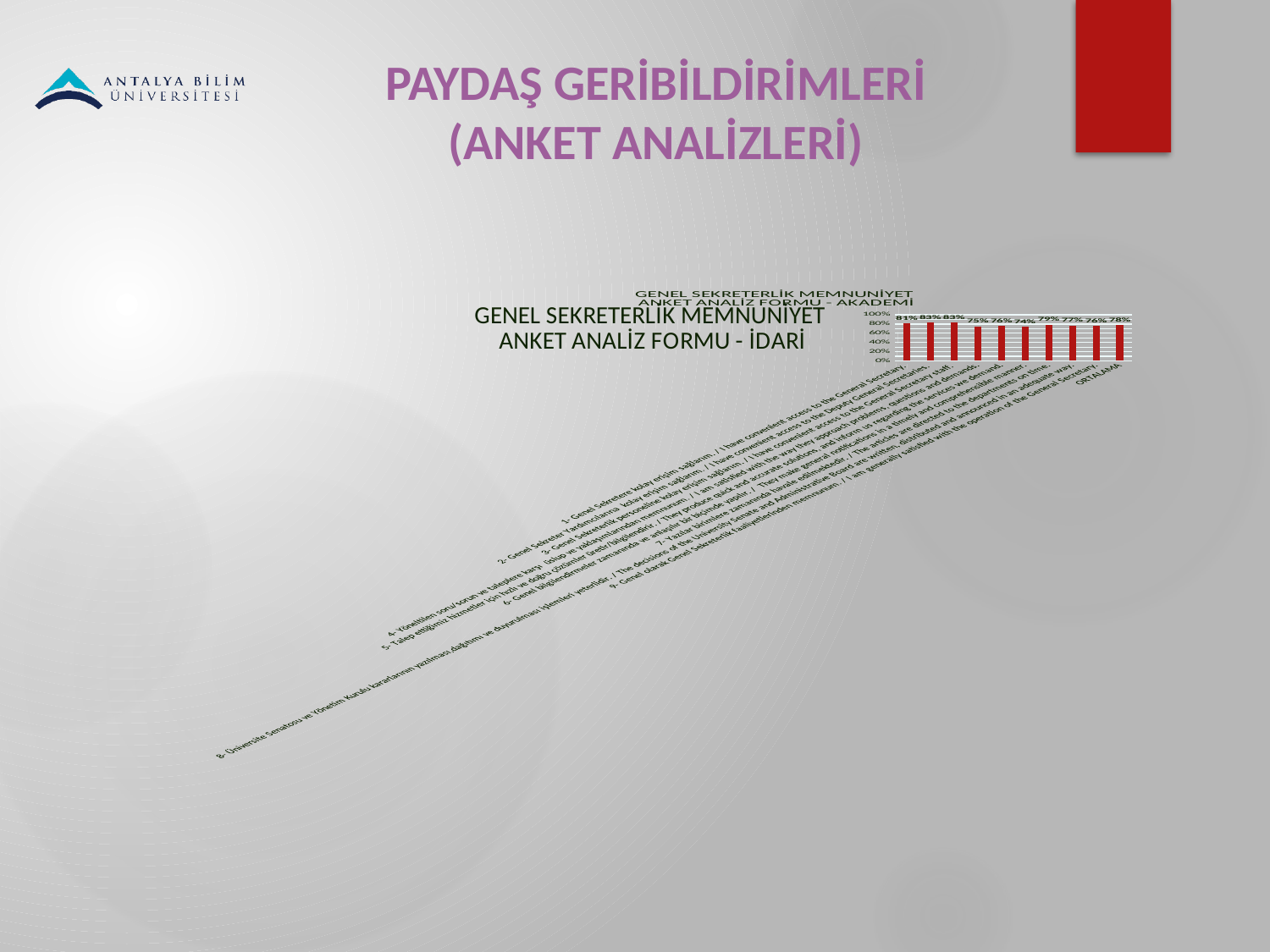
Is the value of the ORTALAMA bar greater or less than 60%? greater What is the value of the first bar (item 1) in the chart? 81% How many bars are plotted in the chart? 10 What is the title of the chart on the slide? GENEL SEKRETERLİK MEMNUNİYET ANKET ANALİZ FORMU - AKADEMİ What is the maximum value shown on the chart's vertical axis? 100% What is the value of the ORTALAMA bar in the chart? 78% What kind of chart is shown on the slide? bar chart What is the lowest value shown on any bar in the chart? 74% What is the highest value shown on any bar in the chart? 83% Which is larger: the first bar (item 1) or the ORTALAMA bar? the first bar (item 1) What is the difference between the highest bar value (83%) and the lowest bar value (74%) in the chart? 9 percentage points